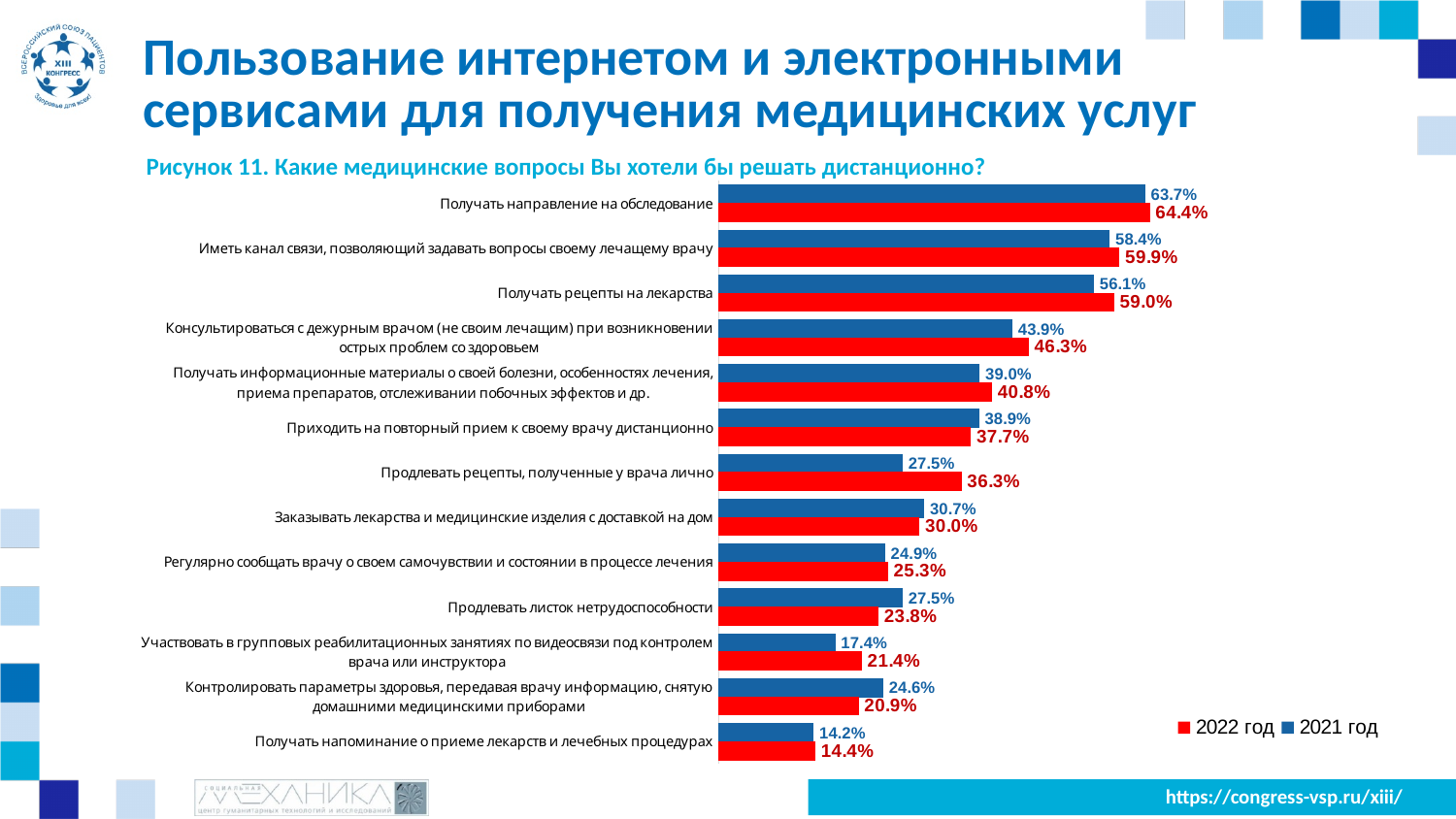
What is the 2021 год value for «Получать рецепты на лекарства»? 56.1% What is the 2022 год value for «Получать направление на обследование»? 64.4% Which colour represents 2022 год in the chart? Red Which category has the highest 2021 год value? Получать направление на обследование For «Продлевать листок нетрудоспособности», which year has the larger value, 2021 год or 2022 год? 2021 год What is the difference between the 2022 год and 2021 год values for «Продлевать рецепты, полученные у врача лично»? 8.8% For «Участвовать в групповых реабилитационных занятиях по видеосвязи под контролем врача или инструктора», which year has the larger value? 2022 год How many categories are shown in the chart? 13 What type of chart is shown on the slide? Bar chart What is the 2022 год value for «Продлевать рецепты, полученные у врача лично»? 36.3% Which category has the lowest 2022 год value? Получать напоминание о приеме лекарств и лечебных процедурах How many series does the legend list? 2